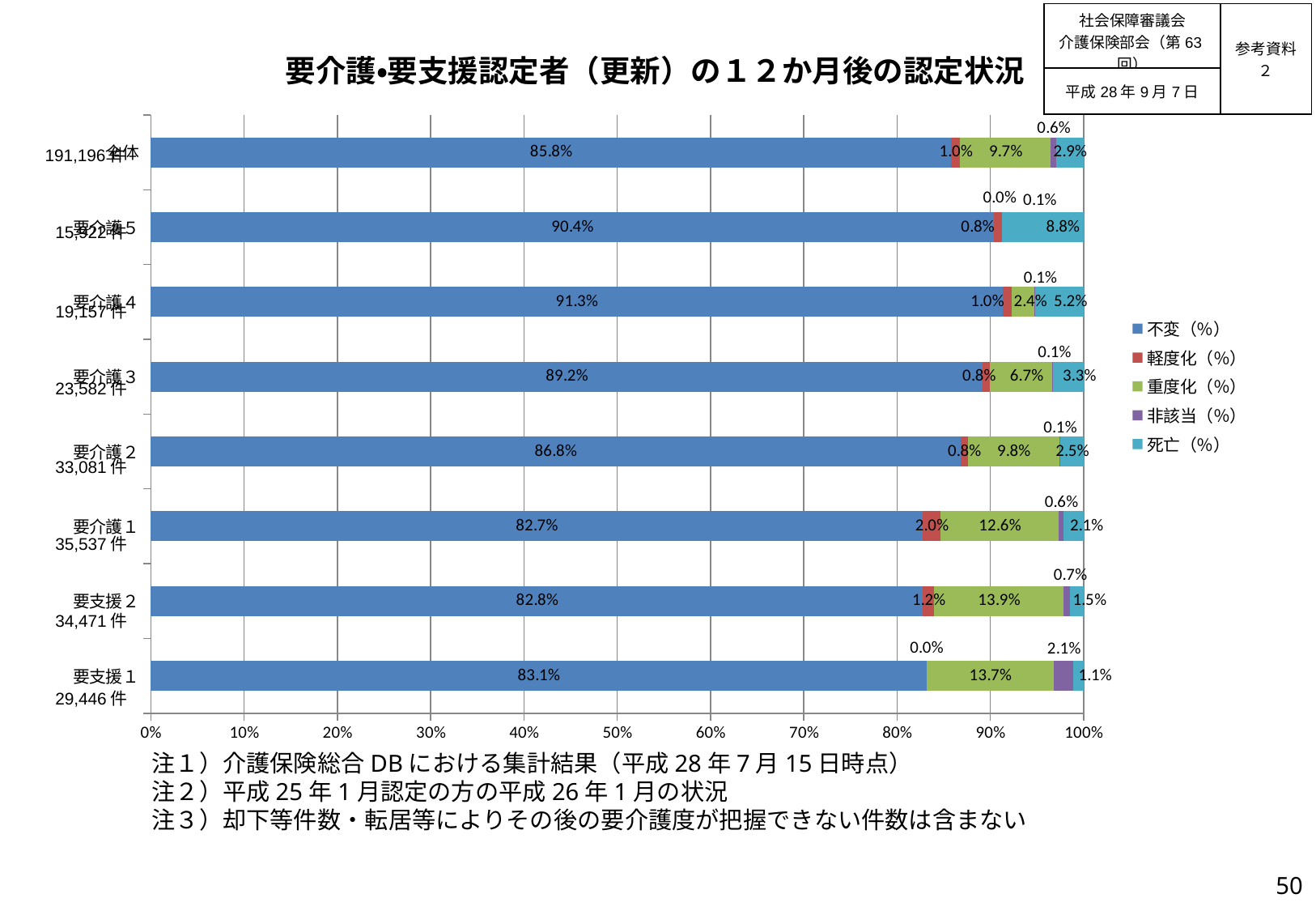
What is the difference between the 重度化 (%) values for 要介護1 and 要介護2? 2.8% What is the 重度化 (%) value for 要支援2? 13.9% How many series does the legend list? 5 Which is larger, the 死亡 (%) value for 要介護3 or for 要介護2? 要介護3 What is the 不変 (%) value for 要介護4? 91.3% Which category has the lowest 死亡 (%) value? 要支援1 How many categories (rows) are plotted in the chart? 8 Which series is shown in green in the chart? 重度化（%） What is the 非該当 (%) value for 要支援1? 2.1% Which category has the highest 不変 (%) value? 要介護4 What kind of chart is shown on the slide? stacked bar chart What is the 死亡 (%) value for 要介護5? 8.8%